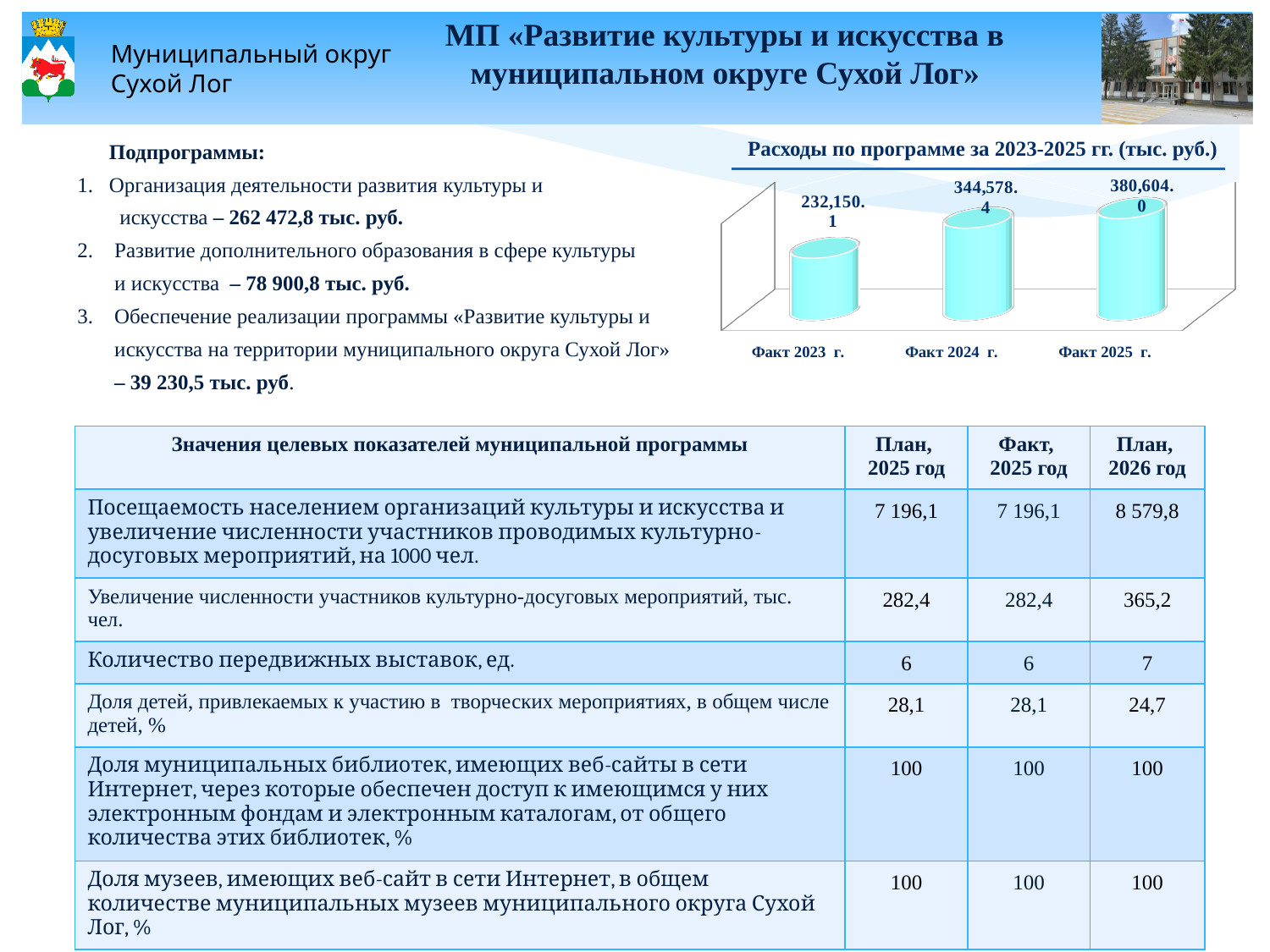
In the chart «Расходы по программе за 2023-2025 гг. (тыс. руб.)», what is the difference between the values for Факт 2025 г. and Факт 2023 г.? 148,453.9 Which category has the lowest value in the chart «Расходы по программе за 2023-2025 гг. (тыс. руб.)»? Факт 2023 г. Which category has the highest value in the chart «Расходы по программе за 2023-2025 гг. (тыс. руб.)»? Факт 2025 г. How many categories are shown in the chart «Расходы по программе за 2023-2025 гг. (тыс. руб.)»? 3 What is the value for Факт 2025 г. in the chart «Расходы по программе за 2023-2025 гг. (тыс. руб.)»? 380,604.0 In the chart «Расходы по программе за 2023-2025 гг. (тыс. руб.)», which is larger: the value for Факт 2024 г. or Факт 2025 г.? Факт 2025 г. What kind of chart is «Расходы по программе за 2023-2025 гг. (тыс. руб.)»? Bar chart What is the title of the chart on the slide? Расходы по программе за 2023-2025 гг. (тыс. руб.) What is the value for Факт 2024 г. in the chart «Расходы по программе за 2023-2025 гг. (тыс. руб.)»? 344,578.4 What is the value for Факт 2023 г. in the chart «Расходы по программе за 2023-2025 гг. (тыс. руб.)»? 232,150.1 In the chart «Расходы по программе за 2023-2025 гг. (тыс. руб.)», what is the difference between the values for Факт 2024 г. and Факт 2023 г.? 112,428.3 Do the values in the chart «Расходы по программе за 2023-2025 гг. (тыс. руб.)» rise or fall from Факт 2023 г. to Факт 2025 г.? Rise